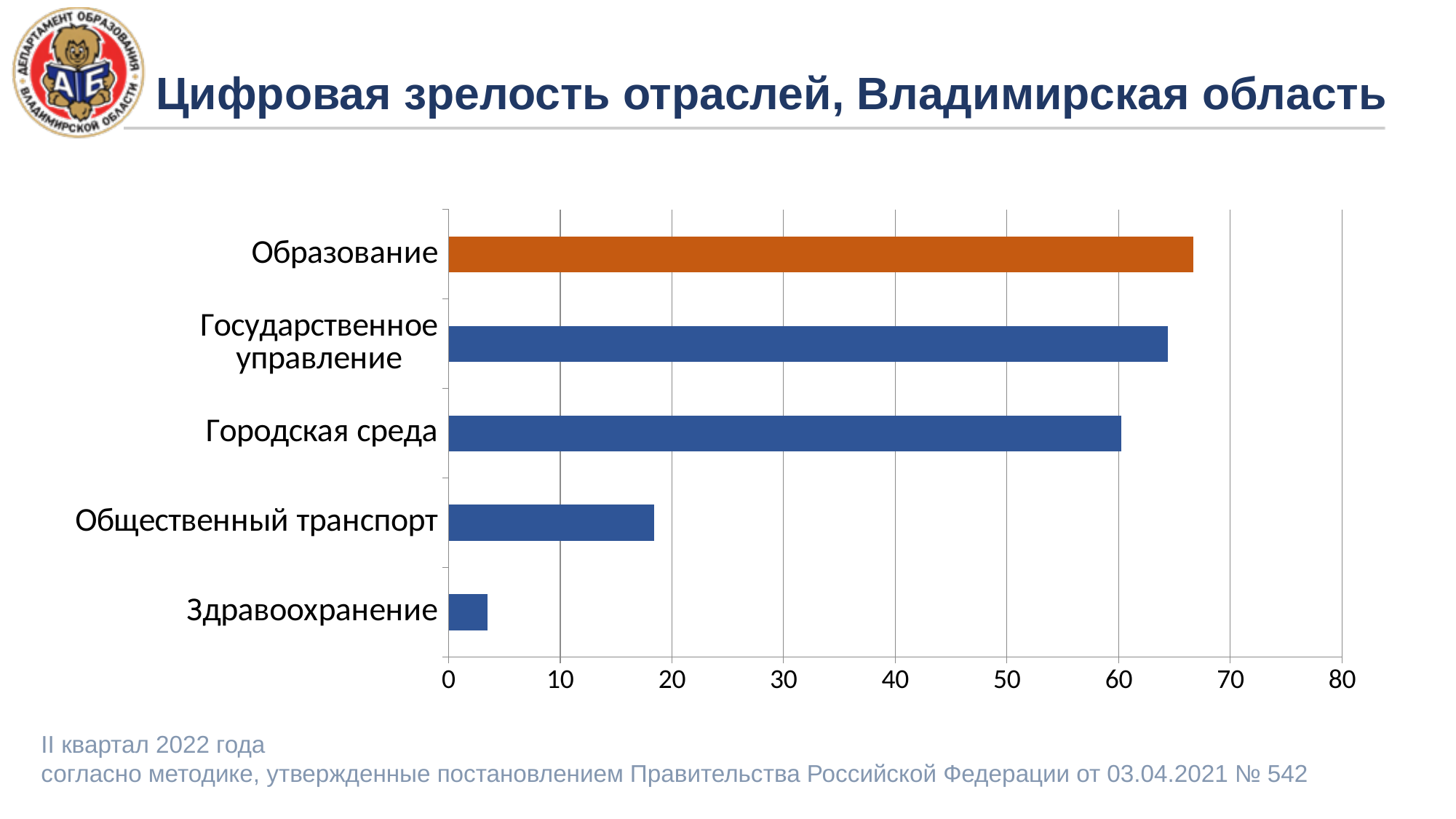
Is the value for Общественный транспорт greater or less than 20? less What kind of chart is shown on the slide? bar chart Is the value for Государственное управление greater or less than 60? greater Which bar in the chart is coloured orange? Образование Which has a larger value: Городская среда or Общественный транспорт? Городская среда Which industry has the lowest digital maturity value in the chart? Здравоохранение How many categories (industries) are shown in the chart? 5 Which industry has the highest digital maturity value in the chart? Образование Is the value for Городская среда greater or less than 50? greater What is the title of the slide? Цифровая зрелость отраслей, Владимирская область